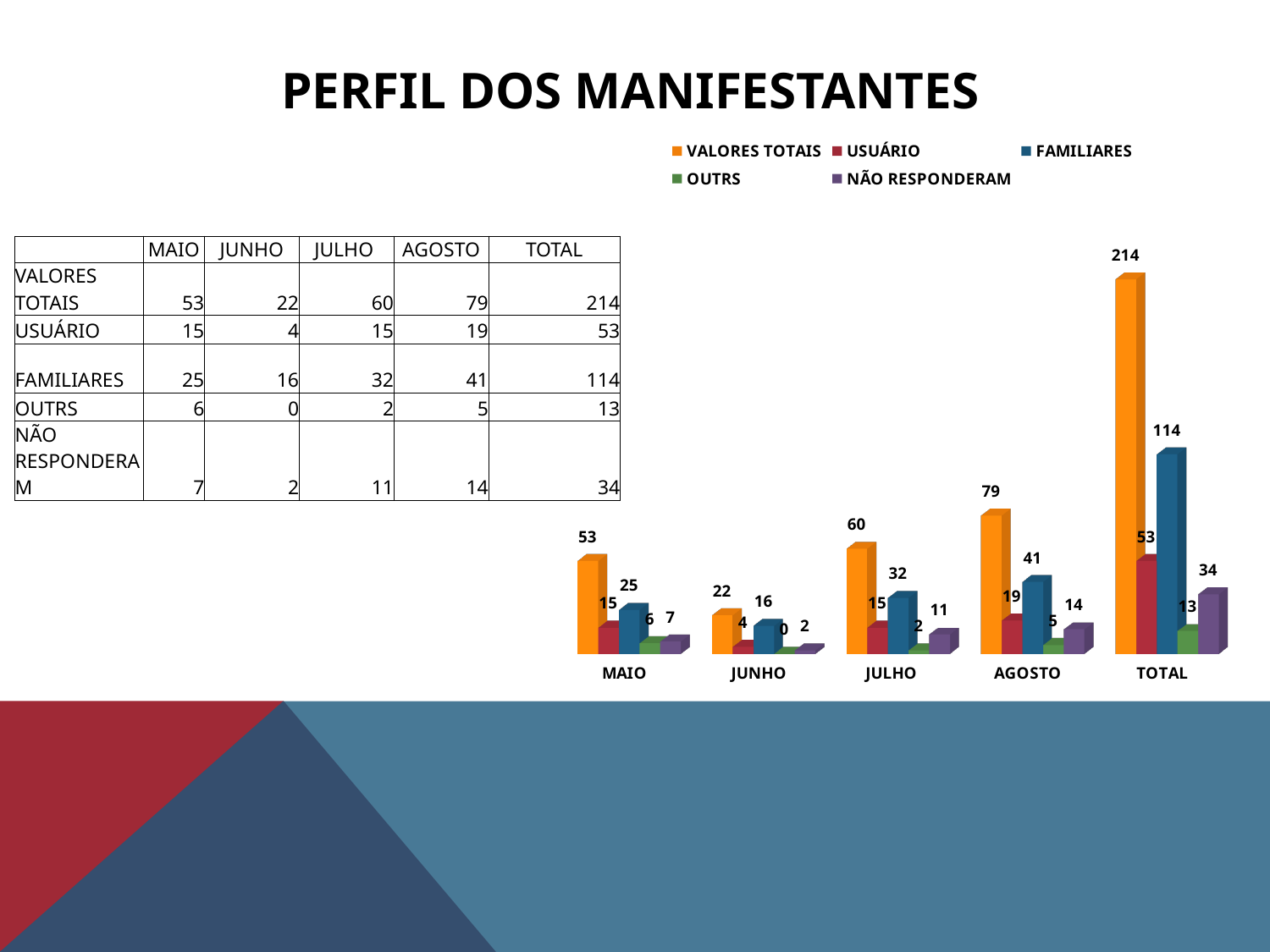
Which series is shown in orange in the chart legend? VALORES TOTAIS Which month has the lowest VALORES TOTAIS value in the chart? JUNHO What is the value of FAMILIARES for JULHO in the chart? 32 Which is larger in the chart: FAMILIARES for MAIO or FAMILIARES for JUNHO? FAMILIARES for MAIO What is the value of VALORES TOTAIS for AGOSTO in the chart? 79 What is the difference between the VALORES TOTAIS values for AGOSTO and JULHO? 19 What is the value of OUTRS for JUNHO in the chart? 0 Which category has the highest VALORES TOTAIS value in the chart? TOTAL How many categories are shown on the x axis of the chart? 5 What kind of chart is shown on the slide? bar chart What is the value of NÃO RESPONDERAM for TOTAL in the chart? 34 How many series does the chart legend list? 5